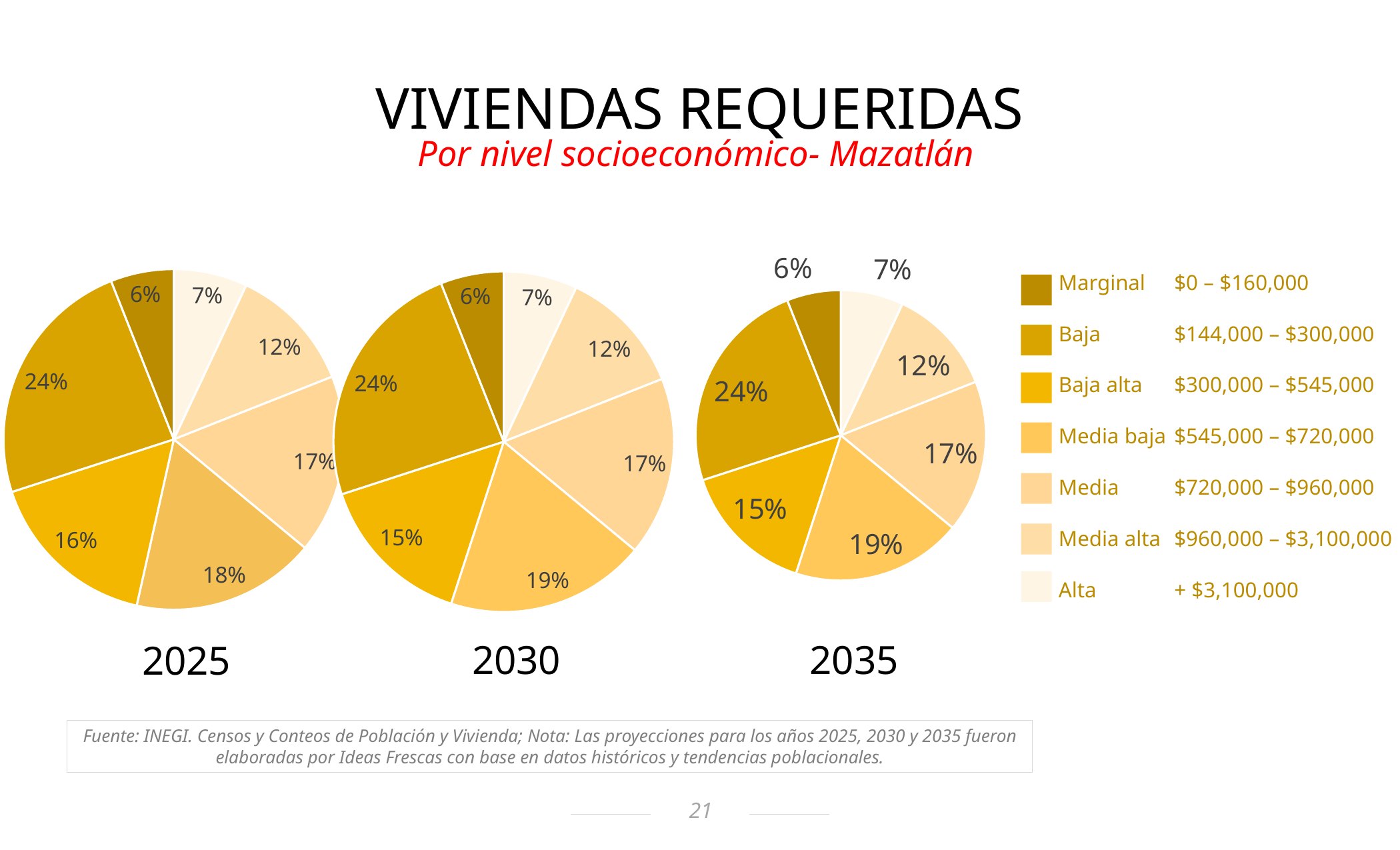
In the 2025 pie chart, what is the difference between the Baja share and the Media alta share? 12% In the 2030 pie chart, what share is labelled for the Media baja segment? 19% In the 2025 pie chart, which category has the smallest share? Marginal In the 2035 pie chart, which category has the largest share? Baja In the 2030 pie chart, which is larger: the Media baja share or the Baja alta share? Media baja What kind of chart is used to show the 2025 data? Pie chart In the 2025 pie chart, what share is labelled for the Baja alta segment? 16% According to the legend, what price range corresponds to the Media category? $720,000 – $960,000 How many categories does the legend list? 7 In the 2035 pie chart, what share is labelled for the Alta segment? 7% In the 2025 pie chart, what share is labelled for the Baja segment? 24% How many slices does the 2030 pie chart have? 7